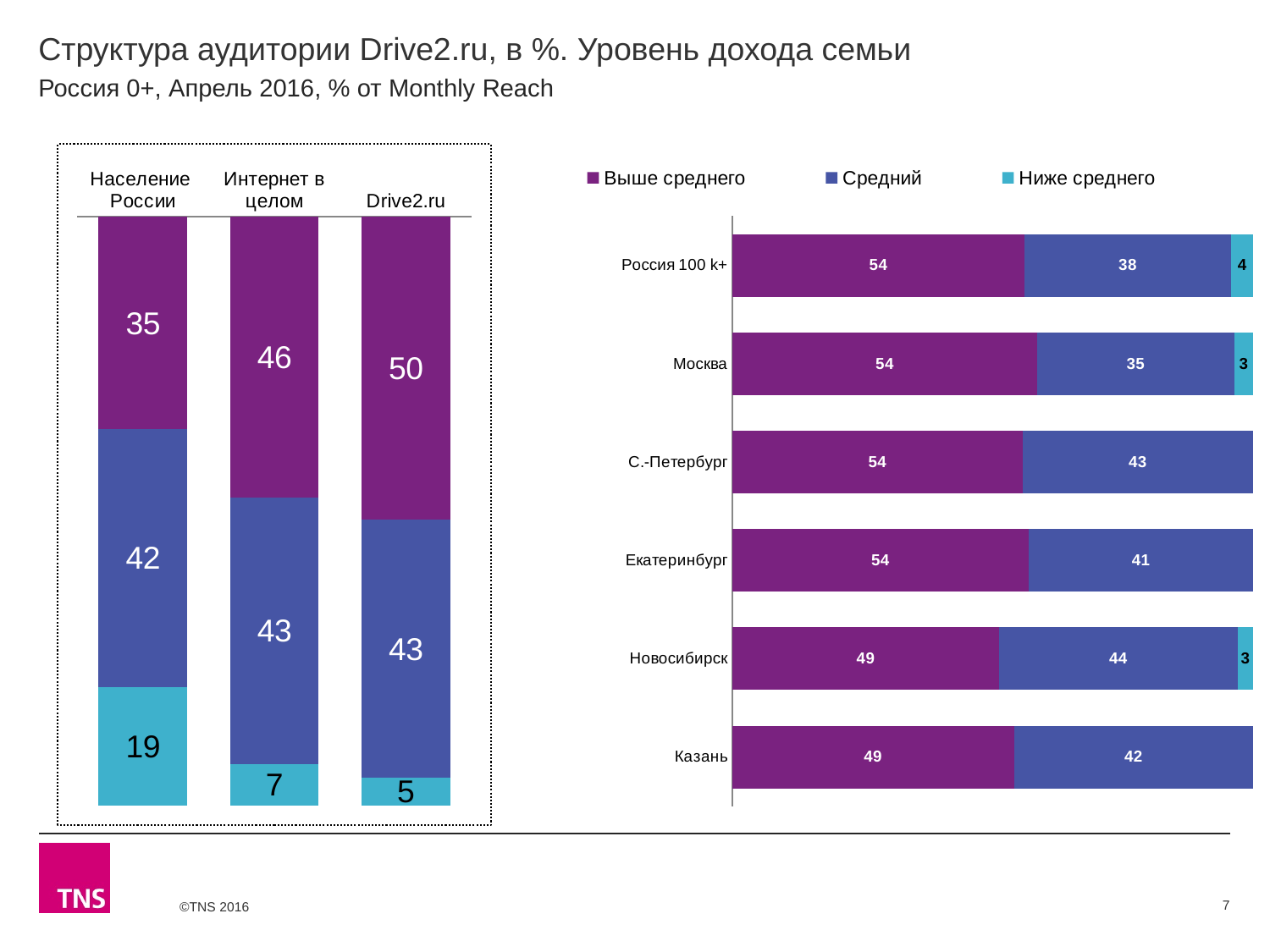
In the left chart, which category has the smallest bottom (light blue) segment? Drive2.ru What type of chart is the right chart? Stacked bar chart In the left chart, what is the difference between the top (purple) segment values for Drive2.ru and Население России? 15 In the right chart, how many series does the legend list? 3 In the right chart, what is the value for Выше среднего for Новосибирск? 49 In the left chart, what is the value of the top (purple) segment for Drive2.ru? 50 In the right chart, which city has the highest value for Средний? Новосибирск In the right chart, what is the value for Ниже среднего for Россия 100 k+? 4 In the left chart, what is the value of the middle (blue) segment for Интернет в целом? 43 In the left chart, how many categories are shown? 3 In the right chart, what is the value for Средний for Москва? 35 In the left chart, what is the value of the bottom (light blue) segment for Население России? 19